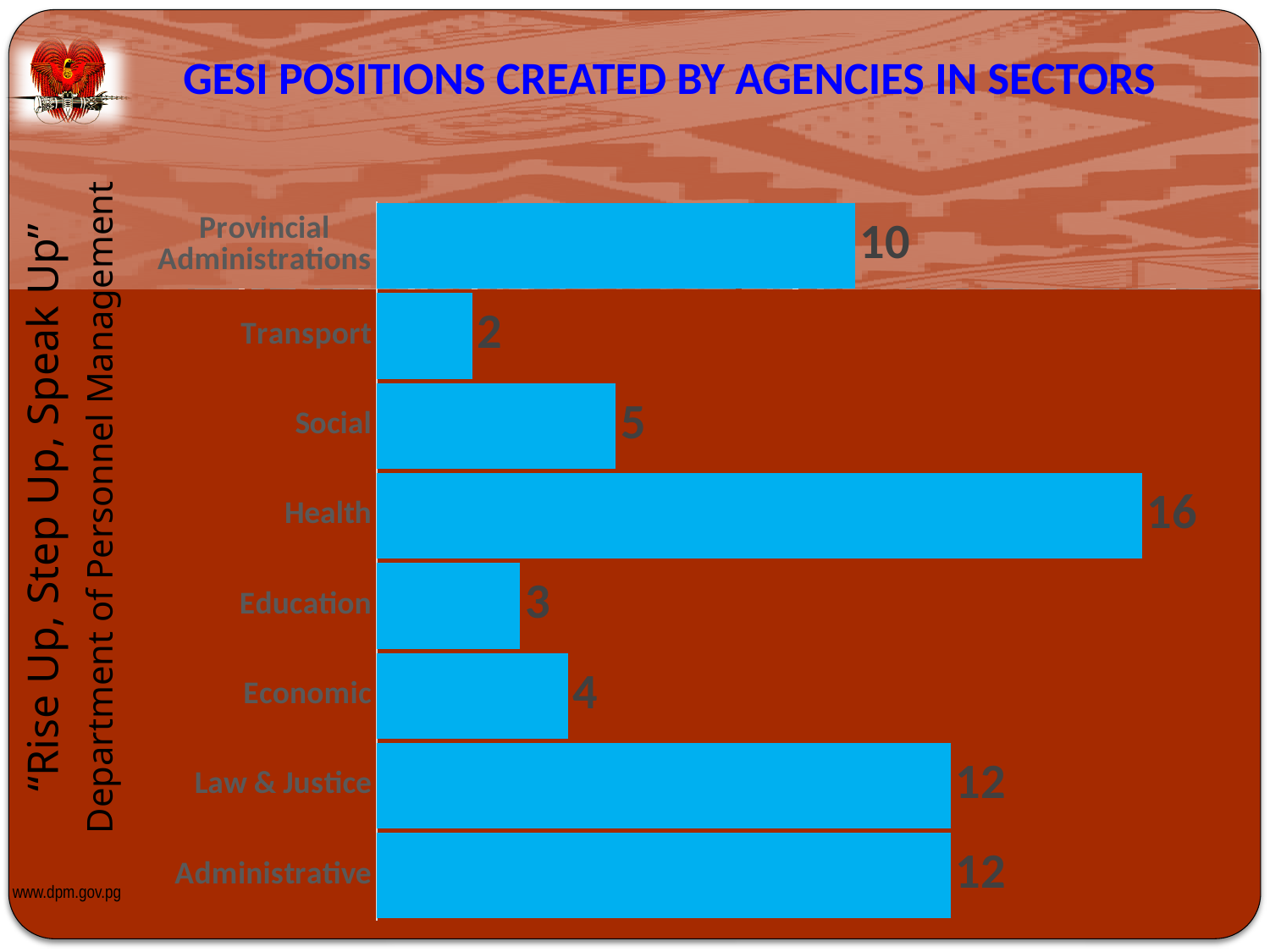
What is the title of the chart on the slide? GESI POSITIONS CREATED BY AGENCIES IN SECTORS Which sector has the highest number of GESI positions created? Health What is the value shown for Provincial Administrations? 10 What is the difference between the values for Law & Justice and Economic? 8 What kind of chart is shown on the slide? Bar chart Which has a larger value, Provincial Administrations or Administrative? Administrative How many GESI positions were created in the Health sector? 16 What is the difference between the values for Health and Social? 11 How many sectors are shown in the chart? 8 Which has a larger value, Education or Economic? Economic Which sector has the lowest number of GESI positions created? Transport What is the value shown for Transport? 2